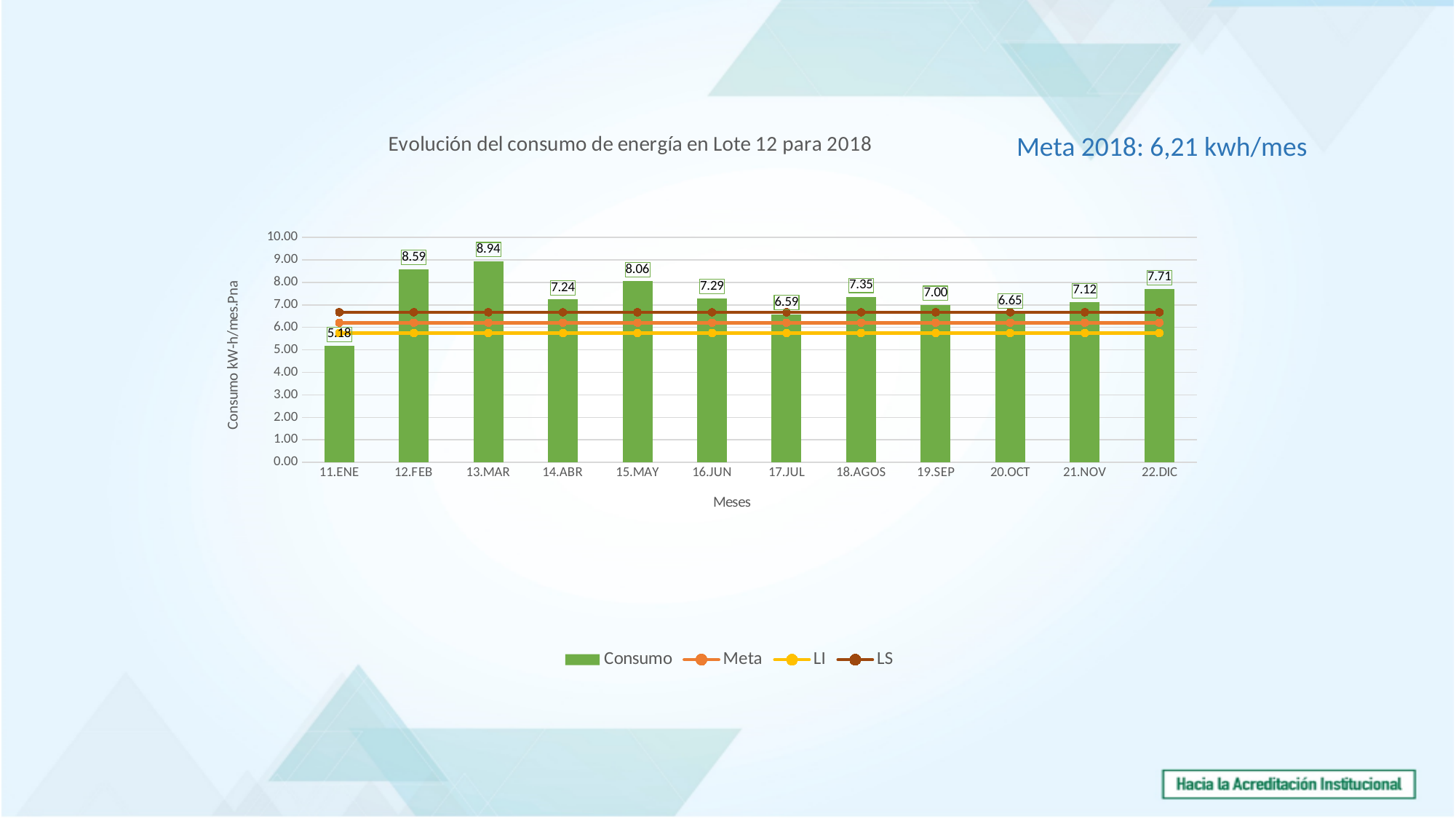
What kind of chart is used to show the Consumo series? bar chart What is the Consumo value for 11.ENE? 5.18 What is the difference between the Consumo values for 13.MAR and 11.ENE? 3.76 How many series does the legend list? 4 Which month has the lowest Consumo value? 11.ENE Is the Meta line value greater or less than 7.00? less Which month has the highest Consumo value? 13.MAR What is the title of the chart? Evolución del consumo de energía en Lote 12 para 2018 What is the Consumo value for 13.MAR? 8.94 What is the Consumo value for 20.OCT? 6.65 How many months are shown on the x axis? 12 Which has a higher Consumo value, 12.FEB or 15.MAY? 12.FEB